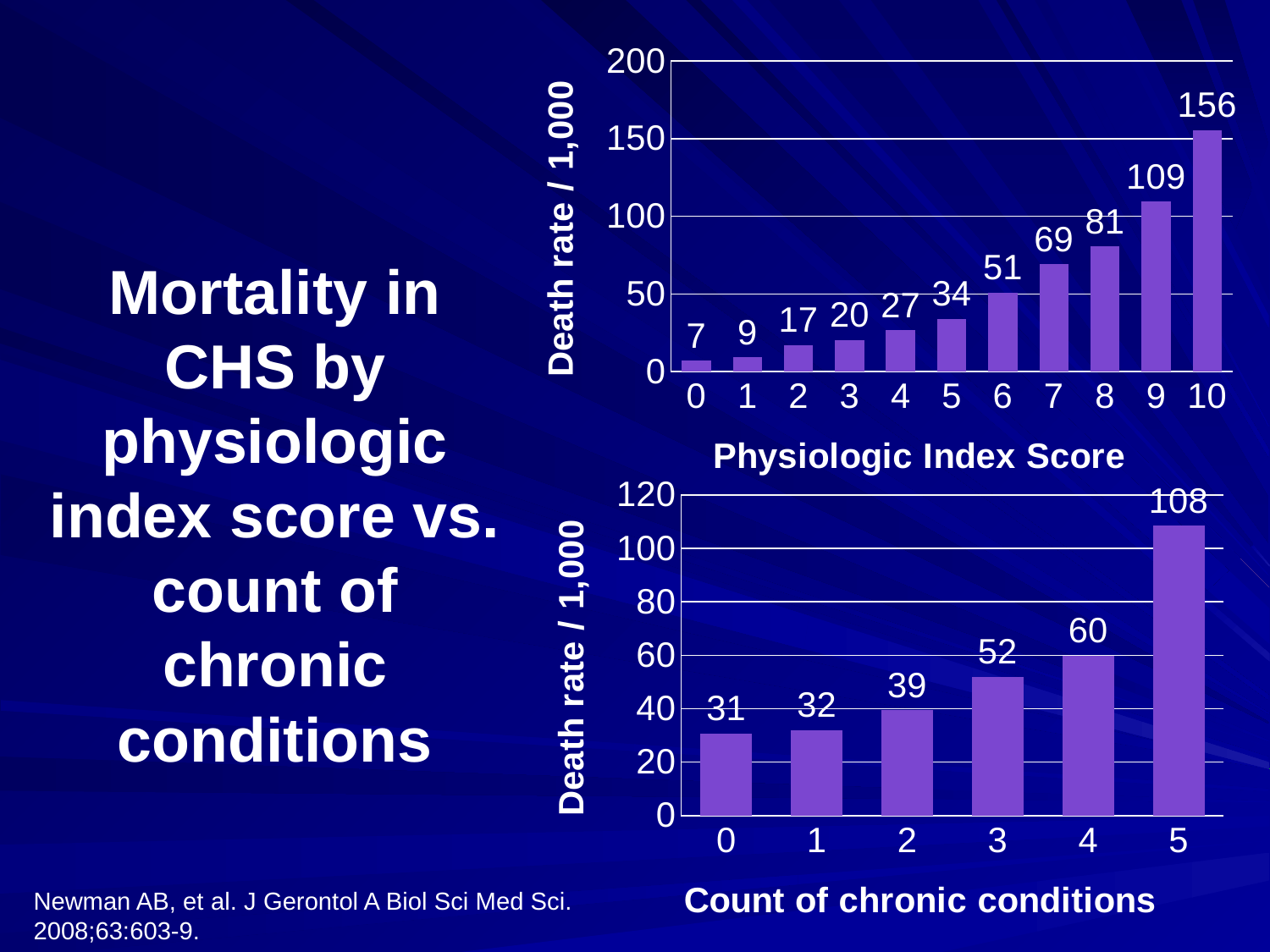
In the bottom chart (Count of chronic conditions), which count has the highest death rate? 5 What type of chart is the bottom chart (Count of chronic conditions)? bar chart In the top chart (Physiologic Index Score), how many score categories are shown on the x axis? 11 In the top chart (Physiologic Index Score), which score has the highest death rate? 10 In the bottom chart (Count of chronic conditions), which has a higher death rate: 2 conditions or 4 conditions? 4 conditions In the top chart (Physiologic Index Score), what is the difference in death rate between scores 10 and 9? 47 In the bottom chart (Count of chronic conditions), what is the difference in death rate between 5 and 4 chronic conditions? 48 In the bottom chart (Count of chronic conditions), how many bars are shown? 6 In the top chart (Physiologic Index Score), which score has the lowest death rate? 0 In the top chart (Physiologic Index Score), what is the death rate per 1,000 for a score of 6? 51 In the bottom chart (Count of chronic conditions), what is the death rate per 1,000 for 3 chronic conditions? 52 In the top chart (Physiologic Index Score), do death rates rise or fall as the score increases? rise